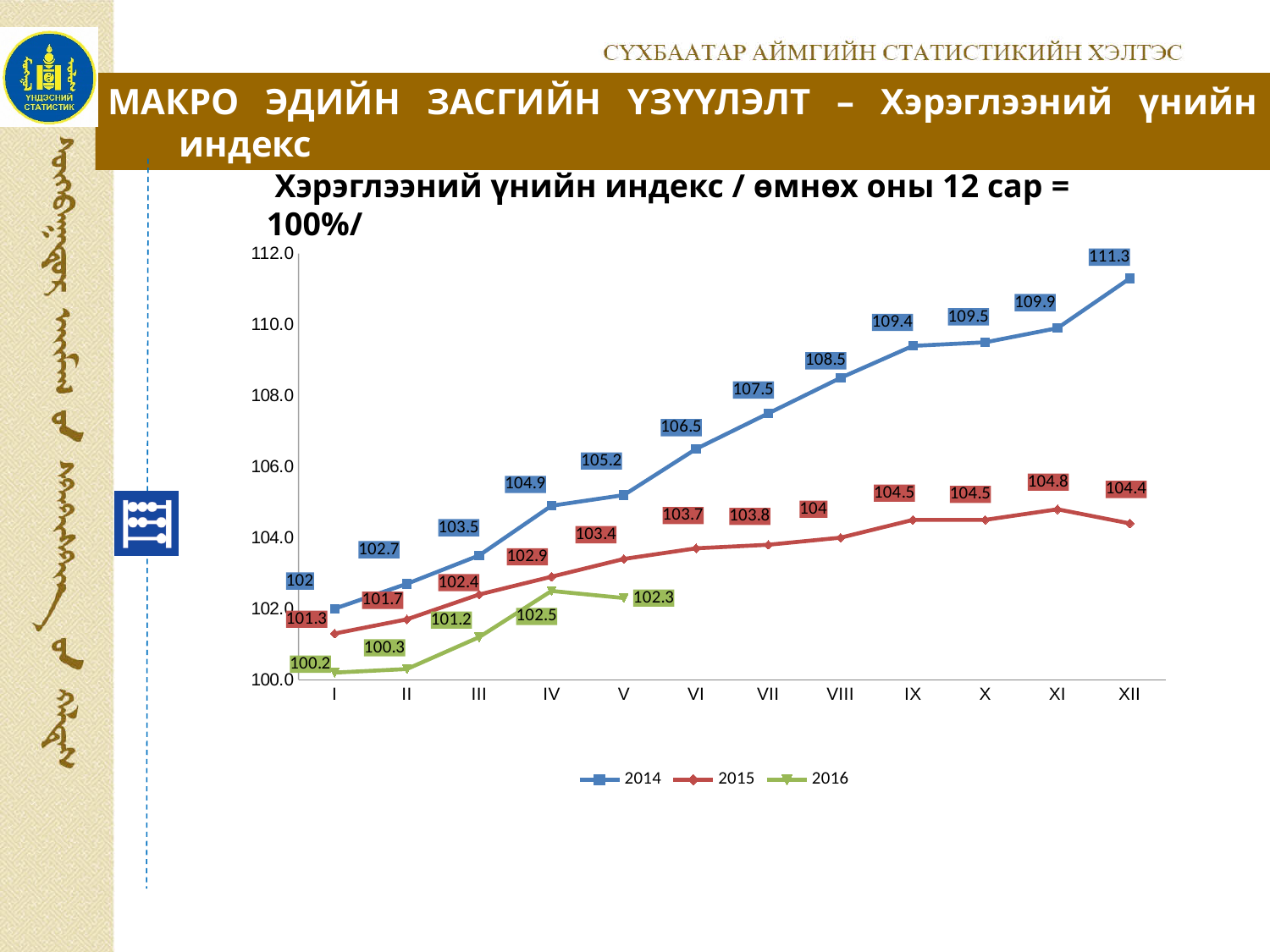
Does the 2014 series generally rise or fall from month I to month XII? rise What is the value for 2015 in month VII? 103.8 In which month is the 2014 series at its lowest value? I What is the value for 2014 in month XII? 111.3 In which month does the 2015 series reach its highest value? XI Which is larger in month V: the 2015 value or the 2016 value? 2015 What is the title of the chart? Хэрэглээний үнийн индекс / өмнөх оны 12 сар = 100%/ What type of chart is shown on the slide? line chart What is the value for 2016 in month IV? 102.5 How many months have a plotted value for the 2016 series? 5 What is the difference between the 2014 and 2015 values in month XII? 6.9 How many series does the legend list? 3